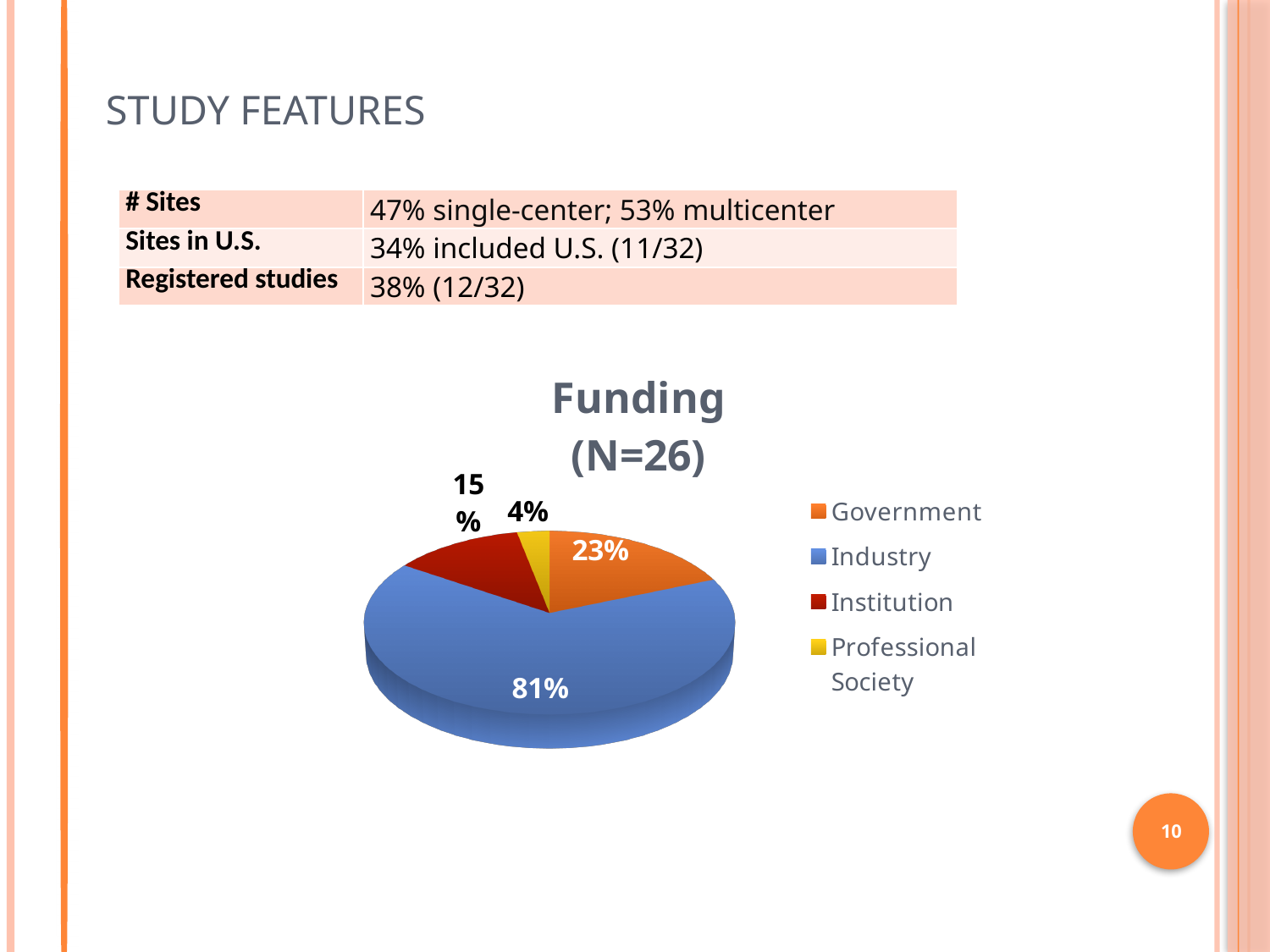
Which funding source has the largest slice in the Funding pie chart? Industry In the Funding pie chart, which is larger: Government or Institution? Government In the Funding pie chart, what percentage is labelled for Industry? 81% Which funding source has the smallest slice in the Funding pie chart? Professional Society In the Funding pie chart, which colour represents Industry? blue In the Funding pie chart, what percentage is labelled for Government? 23% In the Funding pie chart, what percentage is labelled for Professional Society? 4% How many funding categories does the legend of the Funding pie chart list? 4 In the Funding pie chart, what is the difference in percentage points between Industry and Government? 58 What kind of chart is shown under the title "Funding (N=26)"? pie chart In the Funding pie chart, what percentage is labelled for Institution? 15% What is the N value stated in the title of the Funding pie chart? 26